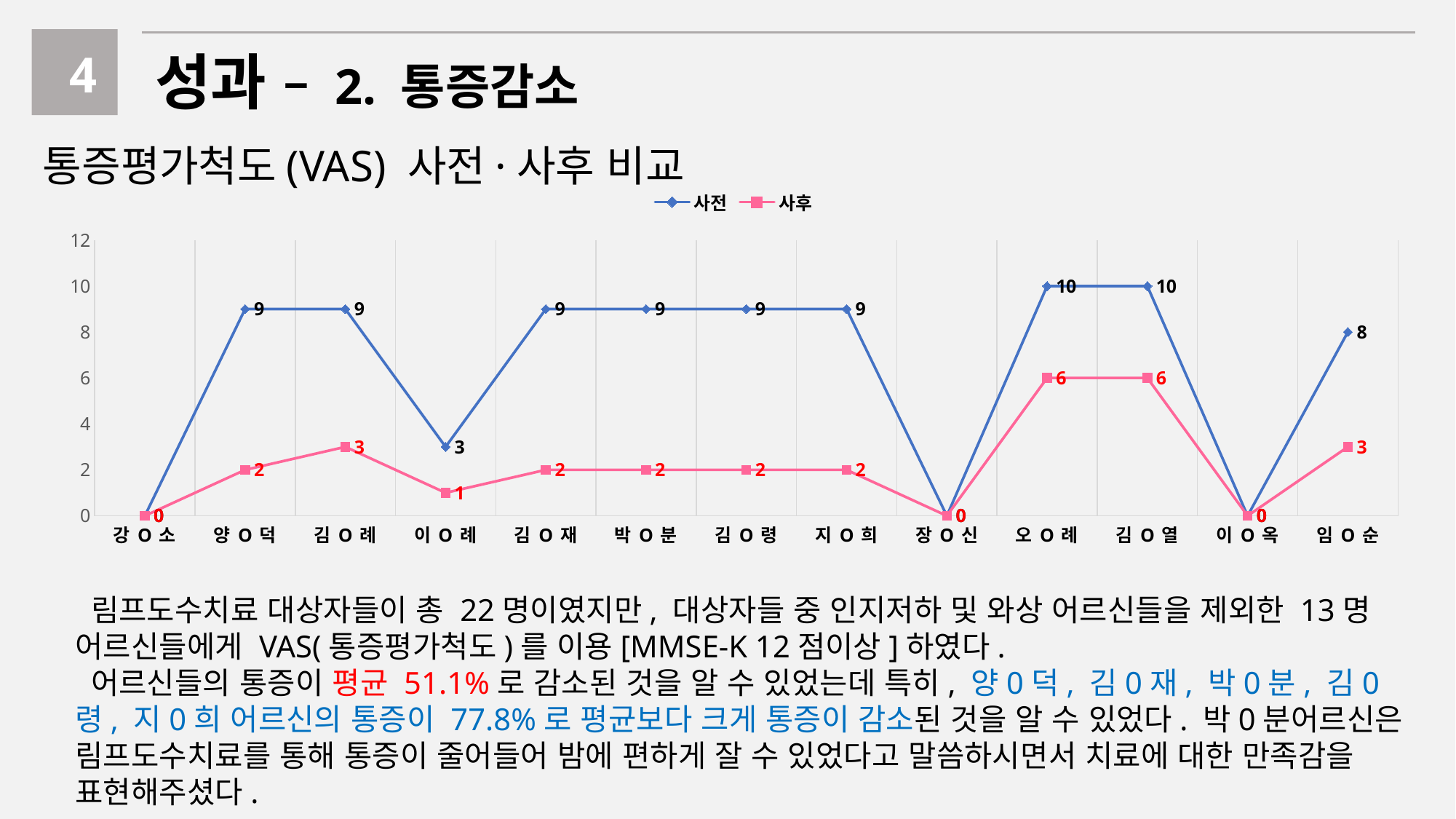
How many categories (people) are plotted along the x axis? 13 What is the highest 사전 value shown on the chart? 10 What are the two series names listed in the legend? 사전, 사후 What is the 사후 value for 오 O 례? 6 What is the 사전 value for 임 O 순? 8 Which is larger, the 사전 value for 이 O 례 or the 사전 value for 임 O 순? 임 O 순 What is the difference between the 사전 and 사후 values for 김 O 열? 4 What is the 사후 value for 김 O 례? 3 How many series does the legend list? 2 What is the difference between the 사전 and 사후 values for 양 O 덕? 7 What is the 사전 value for 이 O 례? 3 What type of chart is shown on the slide? line chart